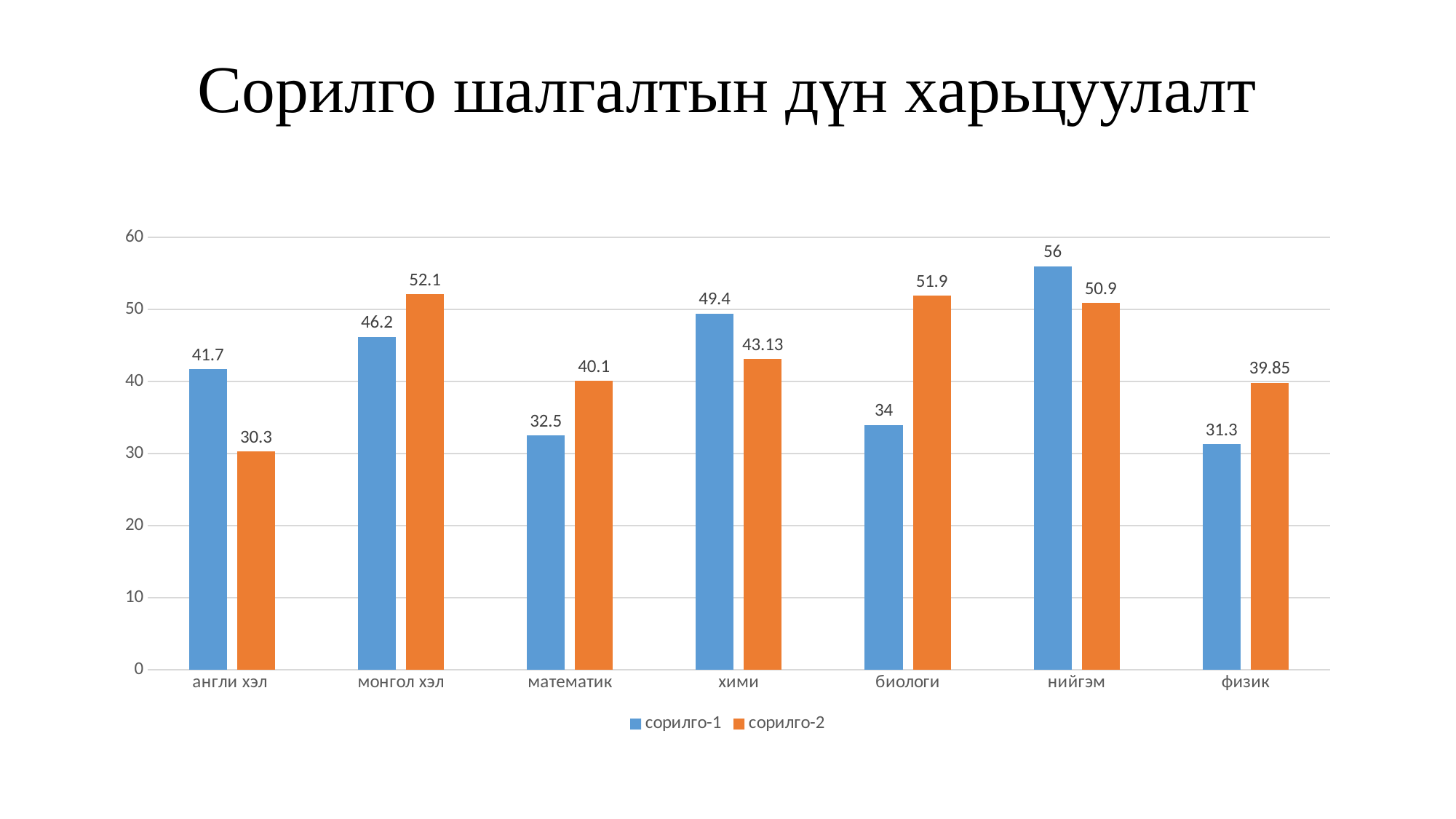
What is the difference between сорилго-2 and сорилго-1 in биологи? 17.9 What is the value for сорилго-1 in математик? 32.5 What is the value for сорилго-2 in хими? 43.13 Which category has the lowest value for сорилго-2? англи хэл How many series does the legend list? 2 What kind of chart is shown on the slide? bar chart How many categories are shown on the x axis? 7 Is the value for сорилго-1 in физик greater or less than 40? less Which is larger in монгол хэл, сорилго-1 or сорилго-2? сорилго-2 Which category has the highest value for сорилго-1? нийгэм What is the title of the slide? Сорилго шалгалтын дүн харьцуулалт What is the value for сорилго-2 in физик? 39.85